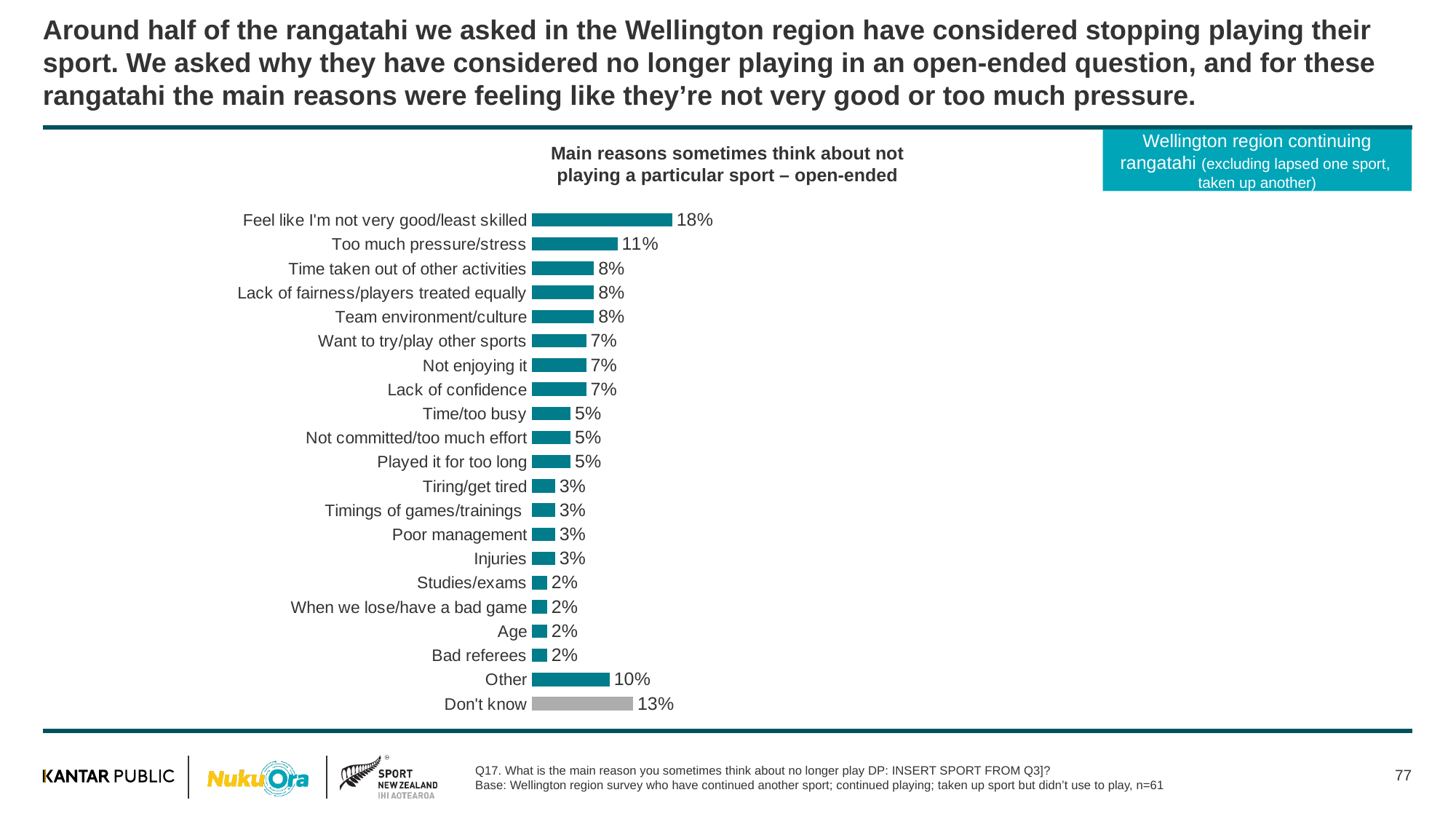
How many categories (bars) are shown in the chart? 21 Which bar in the chart is coloured grey rather than teal? Don't know Which is larger: "Time taken out of other activities" or "Time/too busy"? Time taken out of other activities What is the value for "Other"? 10% What percentage of respondents gave "Feel like I'm not very good/least skilled" as a main reason? 18% Which is larger: the value for "Other" or the value for "Don't know"? Don't know What percentage is shown for "Don't know"? 13% Which reason has the highest percentage in the chart? Feel like I'm not very good/least skilled What is the difference between "Feel like I'm not very good/least skilled" and "Too much pressure/stress"? 7% What is the value shown for "Bad referees"? 2% What is the value shown for "Too much pressure/stress"? 11% What kind of chart is shown on the slide? Bar chart